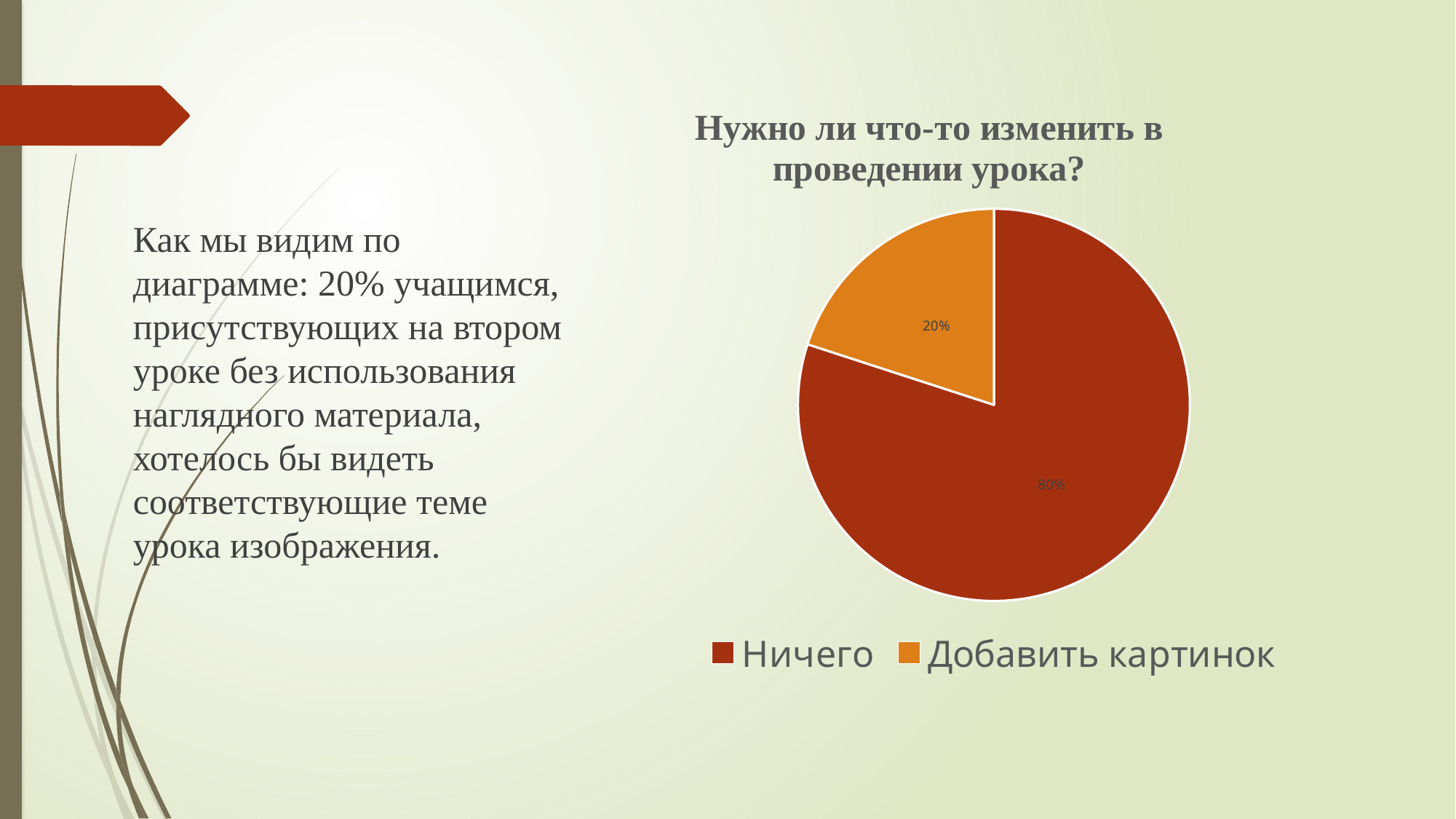
What share of the pie does "Добавить картинок" take? 20% How many entries does the legend list? 2 What colour is the slice for "Добавить картинок"? orange What is the title of the chart? Нужно ли что-то изменить в проведении урока? What share of the pie does "Ничего" take? 80% Which category has the smallest slice of the pie? Добавить картинок What kind of chart is shown on the slide? pie chart Which is larger: the slice for "Ничего" or the slice for "Добавить картинок"? Ничего What is the difference between the shares of "Ничего" and "Добавить картинок"? 60% How many slices does the pie chart have? 2 Which category has the largest slice of the pie? Ничего